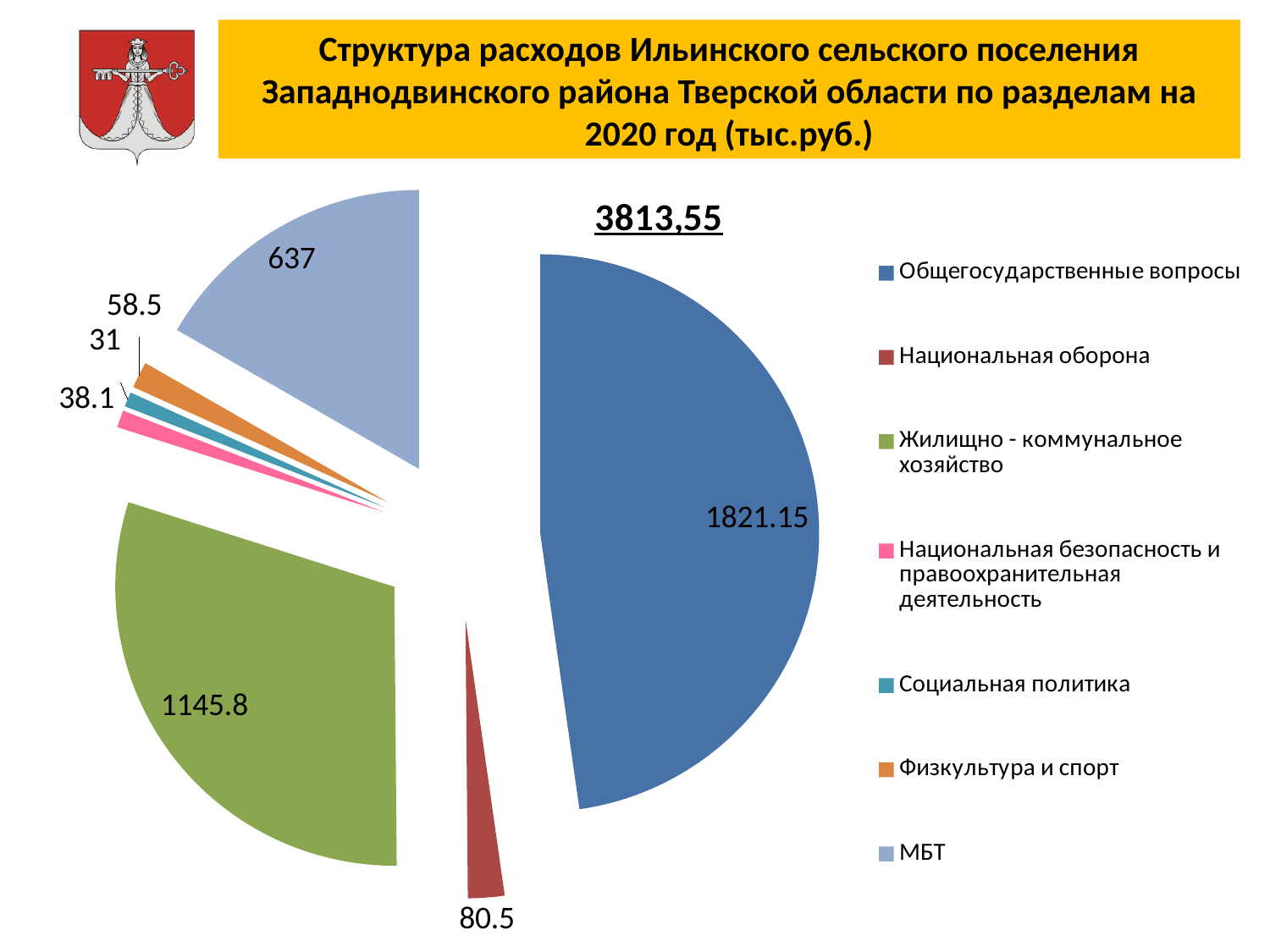
Which is larger, the value for МБТ or the value for Национальная оборона? МБТ How many categories are shown in the pie chart? 7 What total figure is printed above the pie chart? 3813,55 What is the value for Жилищно - коммунальное хозяйство? 1145.8 What is the value for Национальная оборона? 80.5 What is the value for Общегосударственные вопросы? 1821.15 What is the value for Физкультура и спорт? 58.5 What is the value for МБТ? 637 Which category has the smallest slice of the pie? Социальная политика What kind of chart is shown on the slide? pie chart Which category has the largest slice of the pie? Общегосударственные вопросы What is the difference between the values for Общегосударственные вопросы and Жилищно - коммунальное хозяйство? 675.35